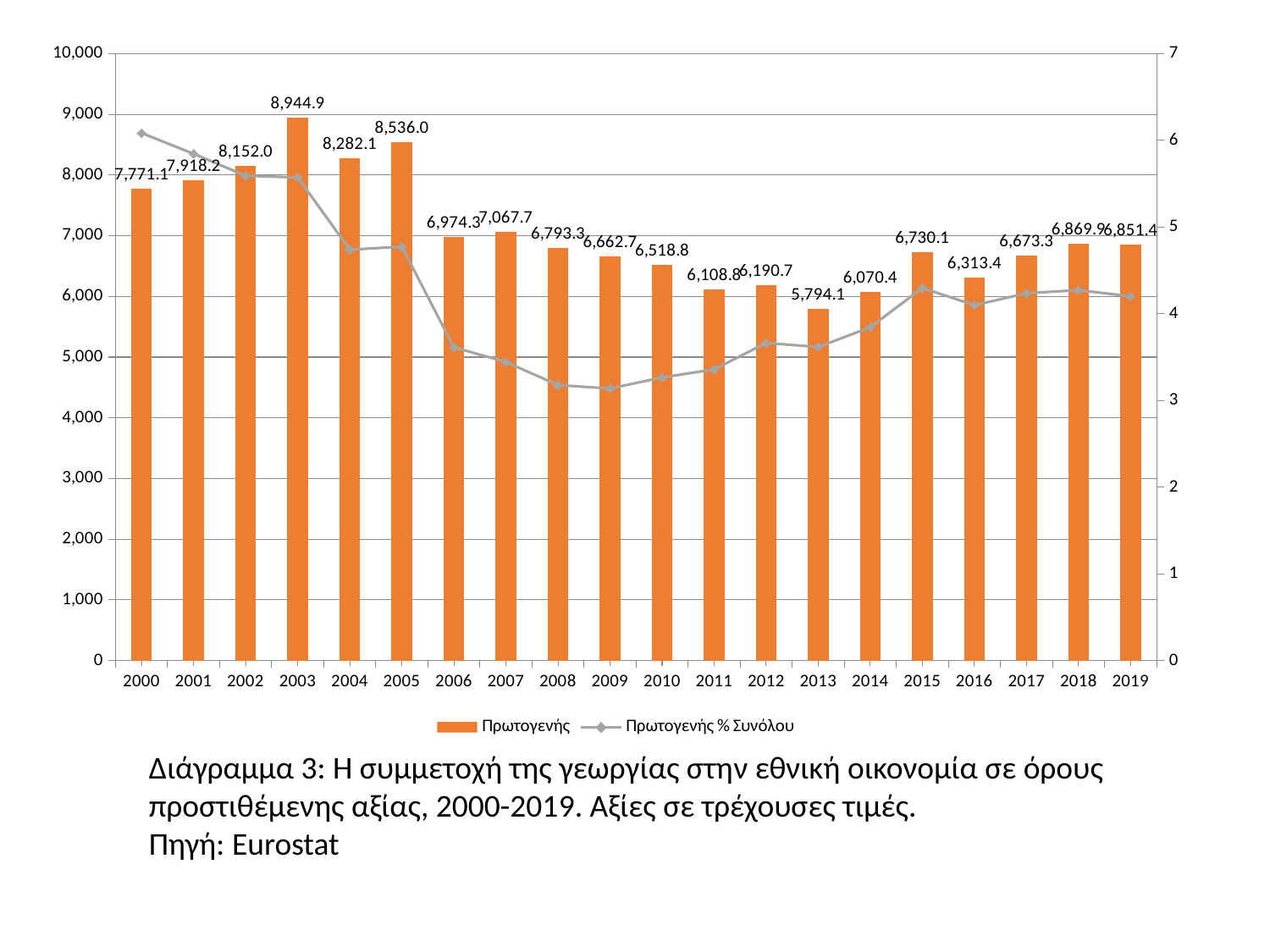
In which year is the Πρωτογενής bar highest? 2003 What kind of chart is this? A bar chart combined with a line chart Is the Πρωτογενής % Συνόλου value for 2009 greater or less than 4 on the right-hand axis? less How many years are shown on the x axis? 20 What is the value of Πρωτογενής for 2013? 5,794.1 In which year is the Πρωτογενής bar lowest? 2013 What is the value of Πρωτογενής for 2019? 6,851.4 How many series does the legend list? 2 Which year has the larger Πρωτογενής value, 2018 or 2019? 2018 Do the Πρωτογενής bars rise or fall from 2005 to 2009? fall What is the difference between the Πρωτογενής values for 2003 and 2013? 3,150.8 What is the value of Πρωτογενής for 2003? 8,944.9